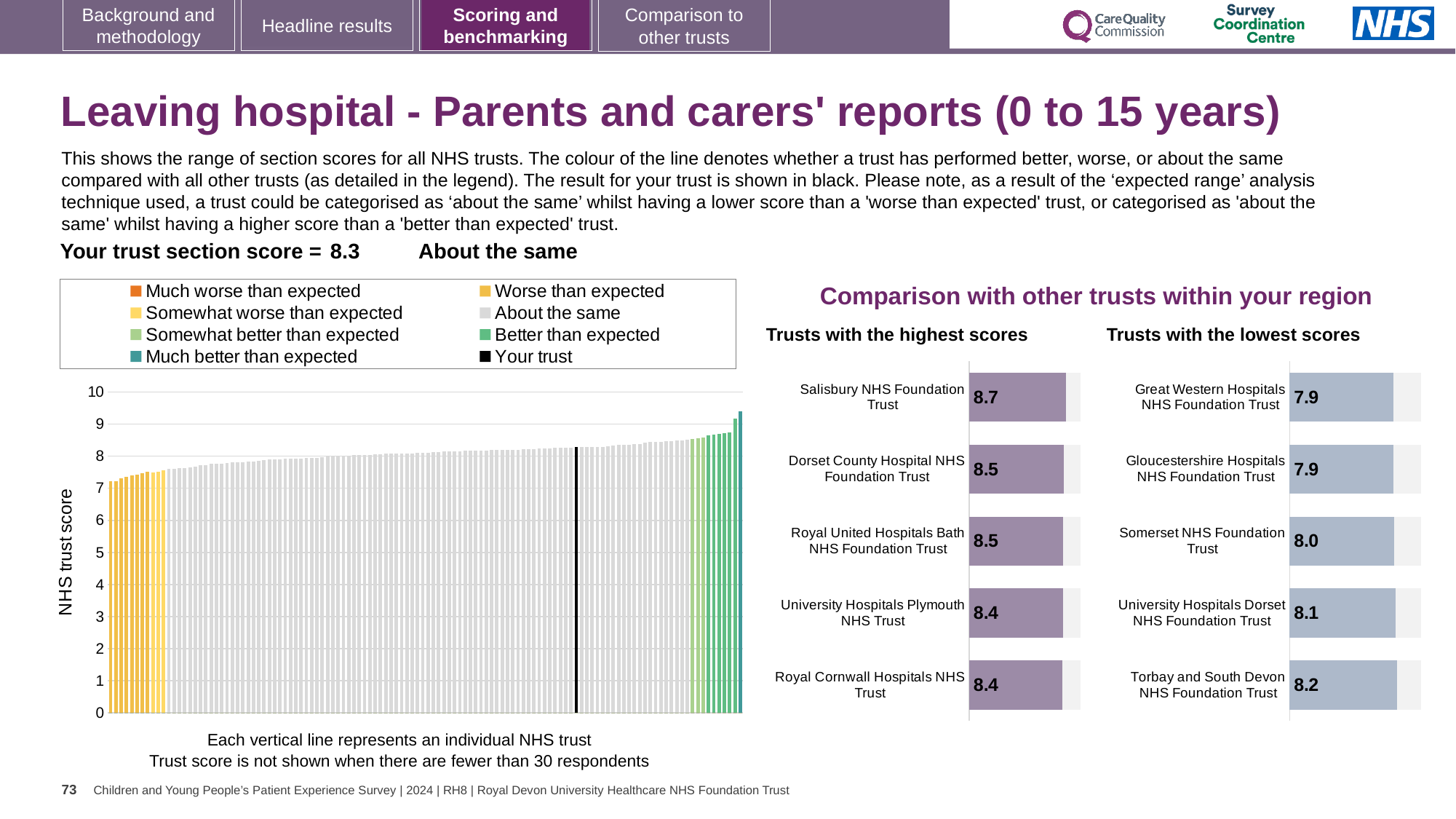
In the 'Trusts with the lowest scores' chart, which trust has the highest score? Torbay and South Devon NHS Foundation Trust In the 'Trusts with the highest scores' chart, which has the larger score: Salisbury NHS Foundation Trust or Dorset County Hospital NHS Foundation Trust? Salisbury NHS Foundation Trust What kind of chart is the main 'NHS trust score' chart on the left? Bar chart In the 'Trusts with the highest scores' chart, what is the score for Salisbury NHS Foundation Trust? 8.7 In the 'Trusts with the lowest scores' chart, what is the score for Somerset NHS Foundation Trust? 8.0 In the main 'NHS trust score' chart on the left, how many entries does the legend list? 8 In the 'Trusts with the lowest scores' chart, how many trusts are shown? 5 In the 'Trusts with the highest scores' chart, what is the difference between the scores of Salisbury NHS Foundation Trust and Royal Cornwall Hospitals NHS Trust? 0.3 In the 'Trusts with the highest scores' chart, which trust has the highest score? Salisbury NHS Foundation Trust In the 'Trusts with the lowest scores' chart, what is the difference between the scores of Torbay and South Devon NHS Foundation Trust and Great Western Hospitals NHS Foundation Trust? 0.3 In the main 'NHS trust score' chart on the left, is the value for your trust (the black line) greater or less than 8? greater In the main 'NHS trust score' chart on the left, do the trust scores rise or fall from left to right? Rise